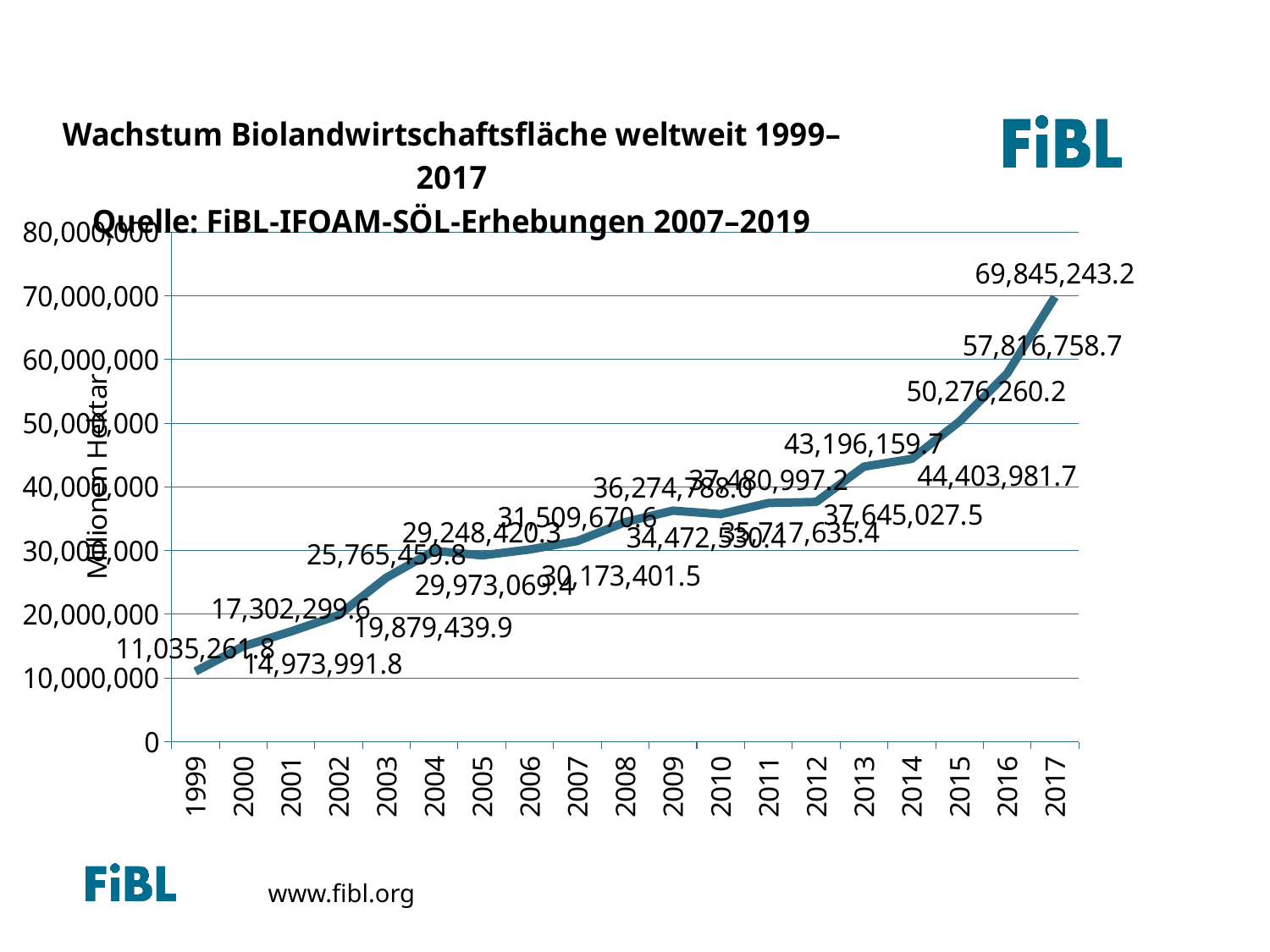
What is the value for 1999? 11,035,261.8 What kind of chart is shown on the slide? line chart What is the value for 2015? 50,276,260.2 What is the value for 2003? 25,765,459.8 Which year has the lowest value? 1999 What is the value for 2017? 69,845,243.2 How many years are plotted on the x axis? 19 What is the difference between the values for 2017 and 2016? 12,028,484.5 Do the values generally rise or fall from 1999 to 2017? rise What is the value for 2016? 57,816,758.7 Is the value for 2013 greater or less than 40,000,000? greater Which year has the highest value? 2017